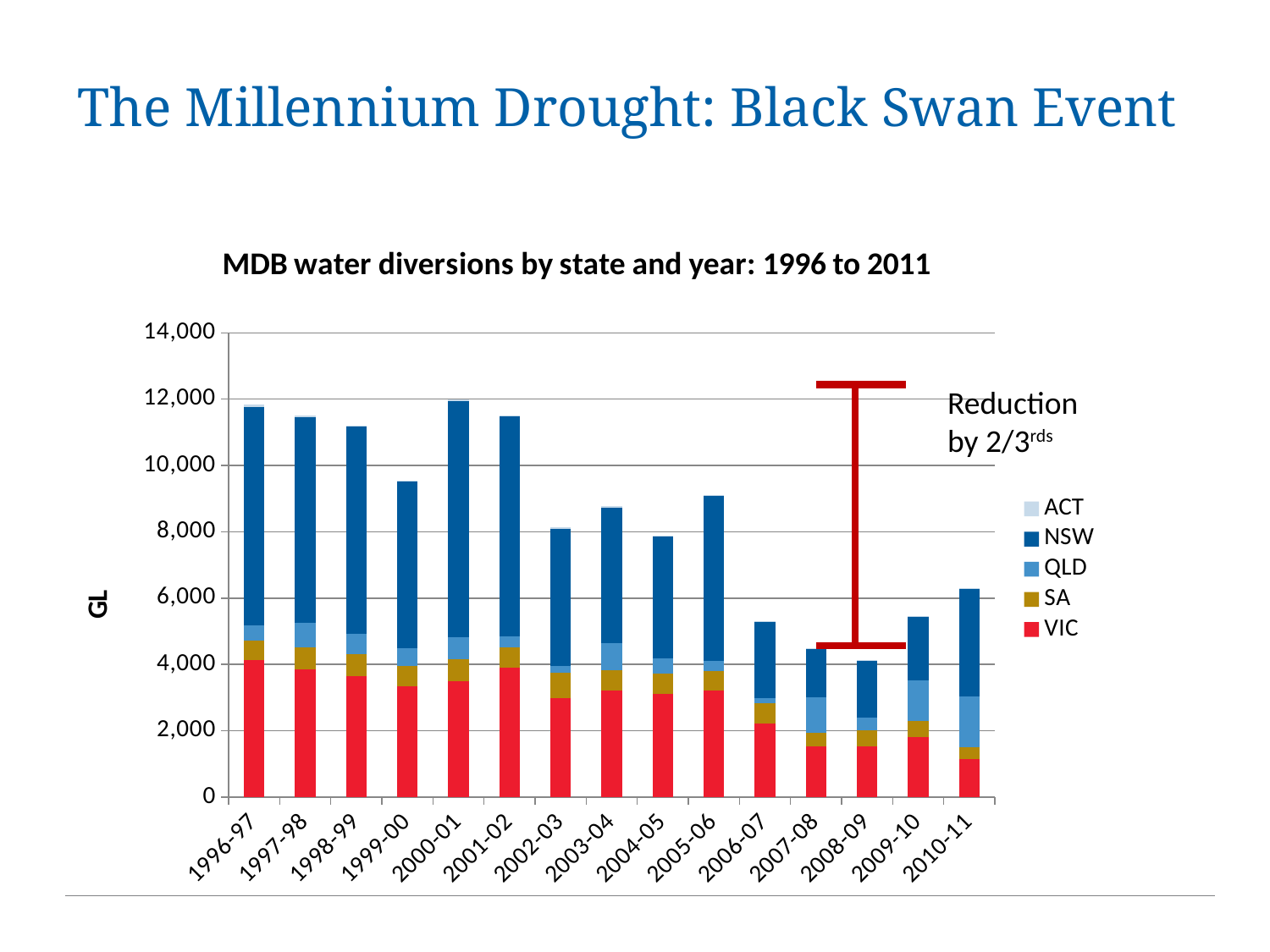
How many series does the chart legend list? 5 How many years (bars) are shown on the x axis? 15 Do total water diversions generally rise or fall from 1996-97 to 2010-11? fall What is the label on the vertical axis? GL Which year has the lowest total water diversion? 2008-09 Is the total value for 2006-07 greater or less than 6,000? less Is the total value for 1996-97 greater or less than 10,000? greater What type of chart is shown on the slide? Stacked bar chart Is the total value for 1999-00 greater or less than 10,000? less Which year has the larger total diversion, 1999-00 or 2000-01? 2000-01 What is the title of the chart? MDB water diversions by state and year: 1996 to 2011